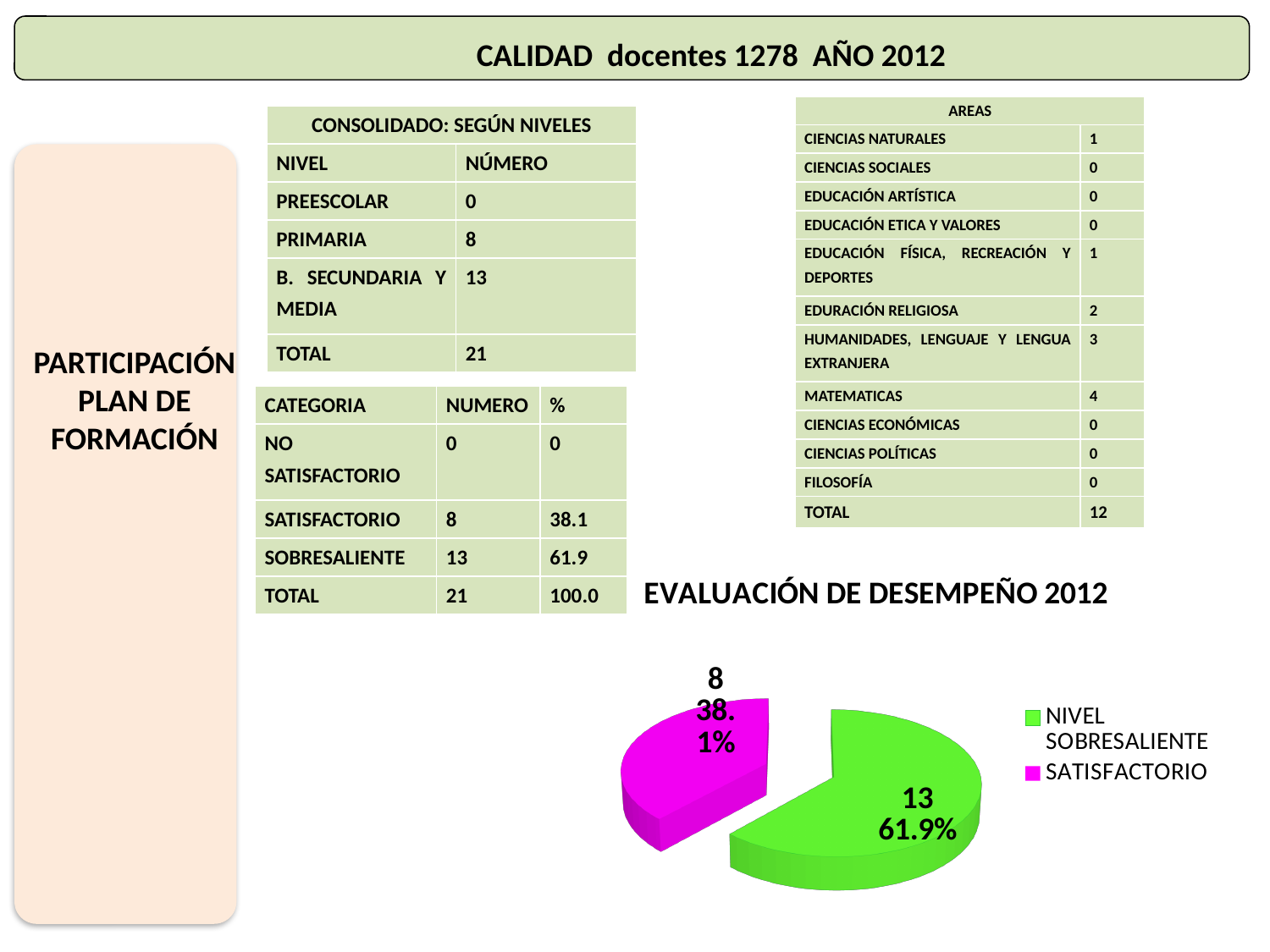
What colour is the SATISFACTORIO slice in the pie chart? magenta How many entries does the pie chart's legend list? 2 In the pie chart, what is the difference between the values for NIVEL SOBRESALIENTE and SATISFACTORIO? 5 In the pie chart, what percentage share does SATISFACTORIO have? 38.1% How many slices does the pie chart have? 2 In the pie chart, what is the value for SATISFACTORIO? 8 What kind of chart is shown under the heading EVALUACIÓN DE DESEMPEÑO 2012? pie chart In the pie chart, what is the value for NIVEL SOBRESALIENTE? 13 In the pie chart, what percentage share does NIVEL SOBRESALIENTE have? 61.9% Which slice of the pie chart is the largest? NIVEL SOBRESALIENTE In the pie chart, which is larger: NIVEL SOBRESALIENTE or SATISFACTORIO? NIVEL SOBRESALIENTE Which slice of the pie chart is the smallest? SATISFACTORIO